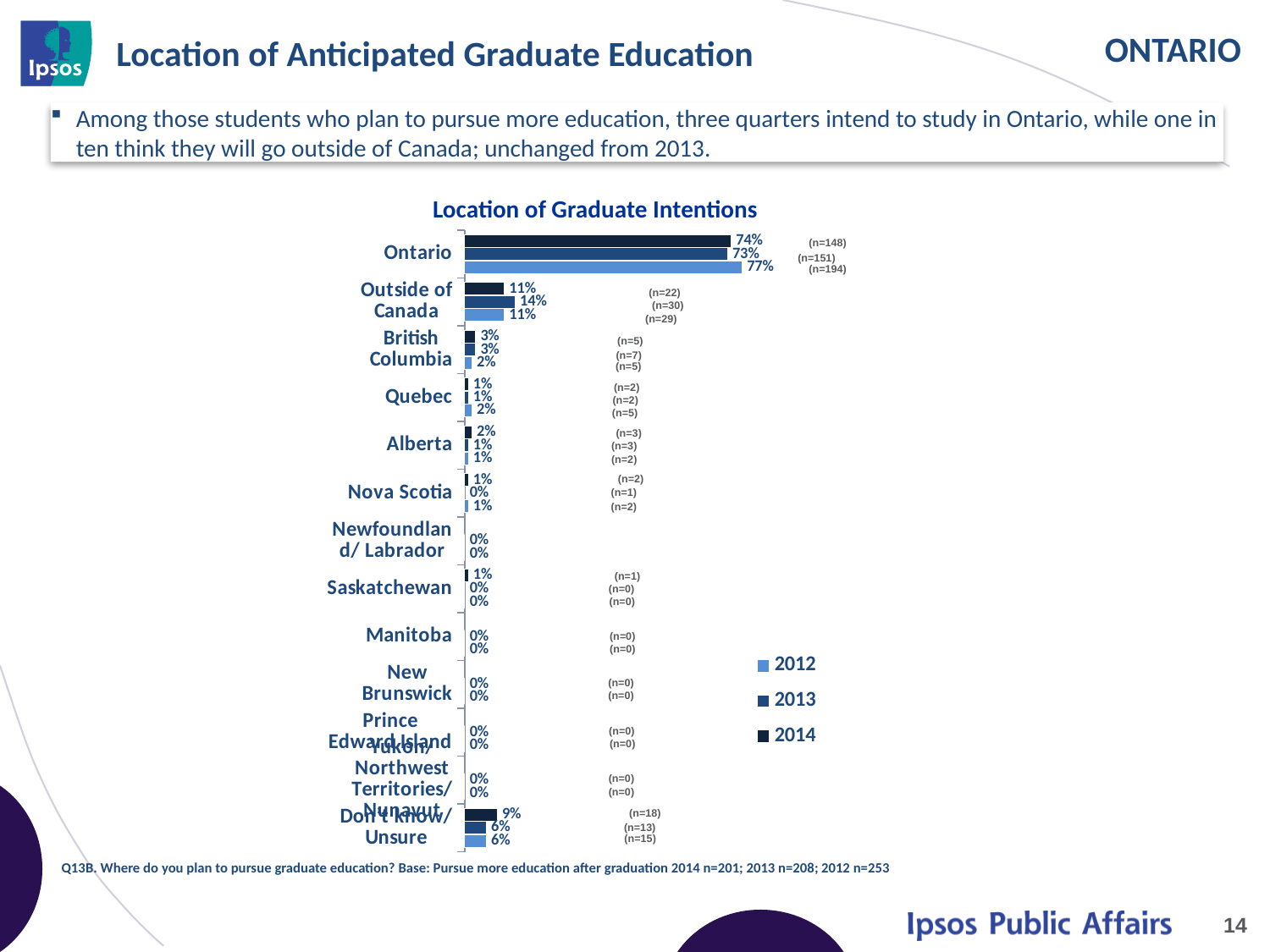
What is the 2014 value for Don't know/Unsure in the Location of Graduate Intentions chart? 9% What is the 2013 value for Outside of Canada in the Location of Graduate Intentions chart? 14% What is the 2014 value for Ontario in the Location of Graduate Intentions chart? 74% How many series does the legend list in the Location of Graduate Intentions chart? 3 Which year is shown in the lightest blue in the legend of the Location of Graduate Intentions chart? 2012 What is the 2014 value for British Columbia in the Location of Graduate Intentions chart? 3% Which category has the highest 2014 value in the Location of Graduate Intentions chart? Ontario What is the difference between the 2012 and 2014 values for Ontario in the Location of Graduate Intentions chart? 3% What is the 2012 value for Ontario in the Location of Graduate Intentions chart? 77% What kind of chart is the Location of Graduate Intentions chart? Bar chart Which is larger for Outside of Canada in the Location of Graduate Intentions chart: the 2013 value or the 2014 value? 2013 How many location categories are shown in the Location of Graduate Intentions chart? 13